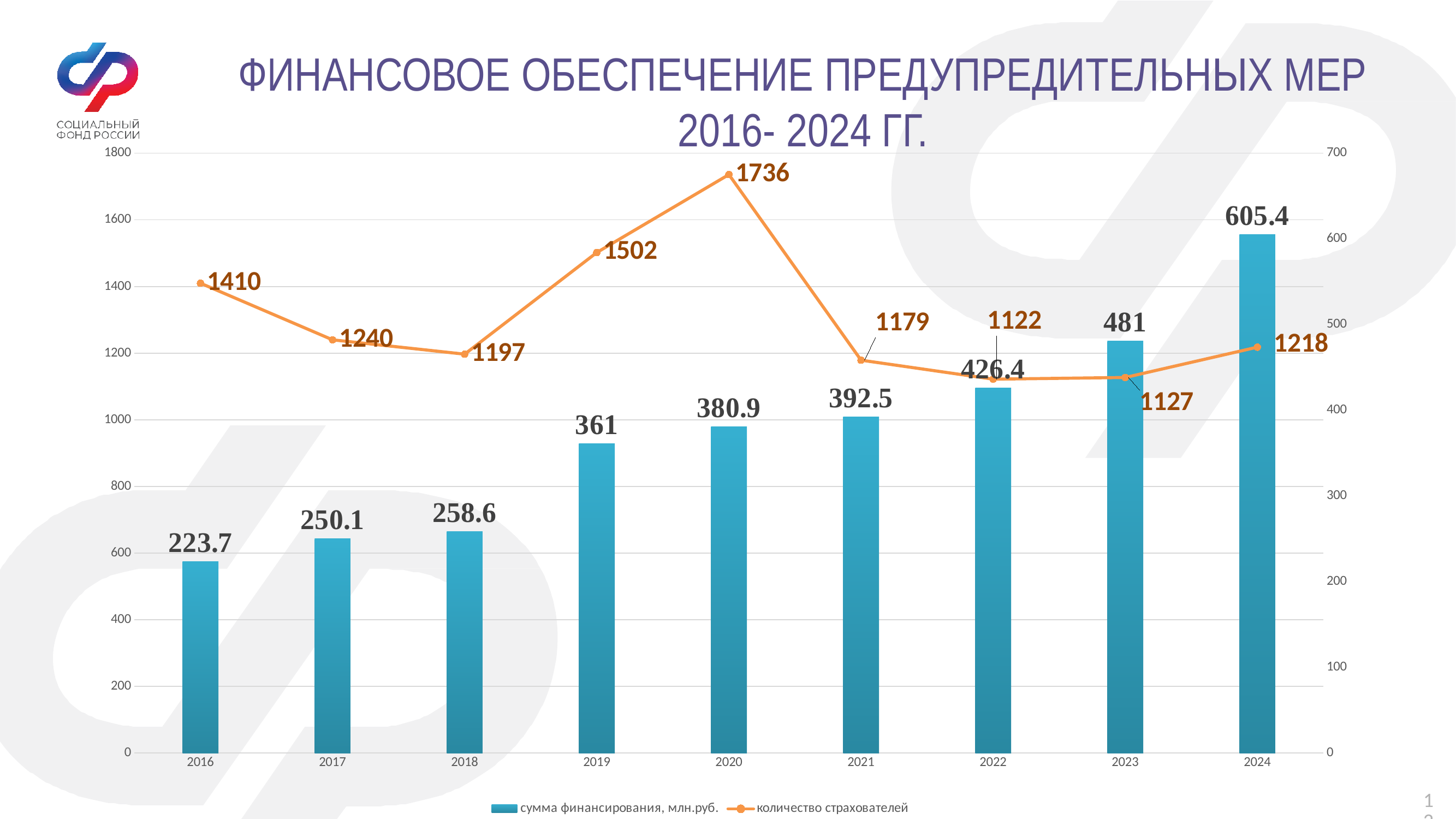
What is the value of "сумма финансирования, млн.руб." for 2019? 361 What is the value of "количество страхователей" for 2020? 1736 What is the value of "количество страхователей" for 2022? 1122 How many series does the legend list? 2 What is the difference between the "сумма финансирования, млн.руб." values for 2024 and 2023? 124.4 Which is larger: "количество страхователей" in 2016 or in 2021? 2016 What is the difference between the "количество страхователей" values for 2020 and 2019? 234 What is the value of "сумма финансирования, млн.руб." for 2024? 605.4 How many years are shown on the x axis? 9 Which year has the lowest value of "количество страхователей"? 2022 Does the "сумма финансирования, млн.руб." series rise or fall from 2016 to 2024? rise Which year has the highest value of "сумма финансирования, млн.руб."? 2024